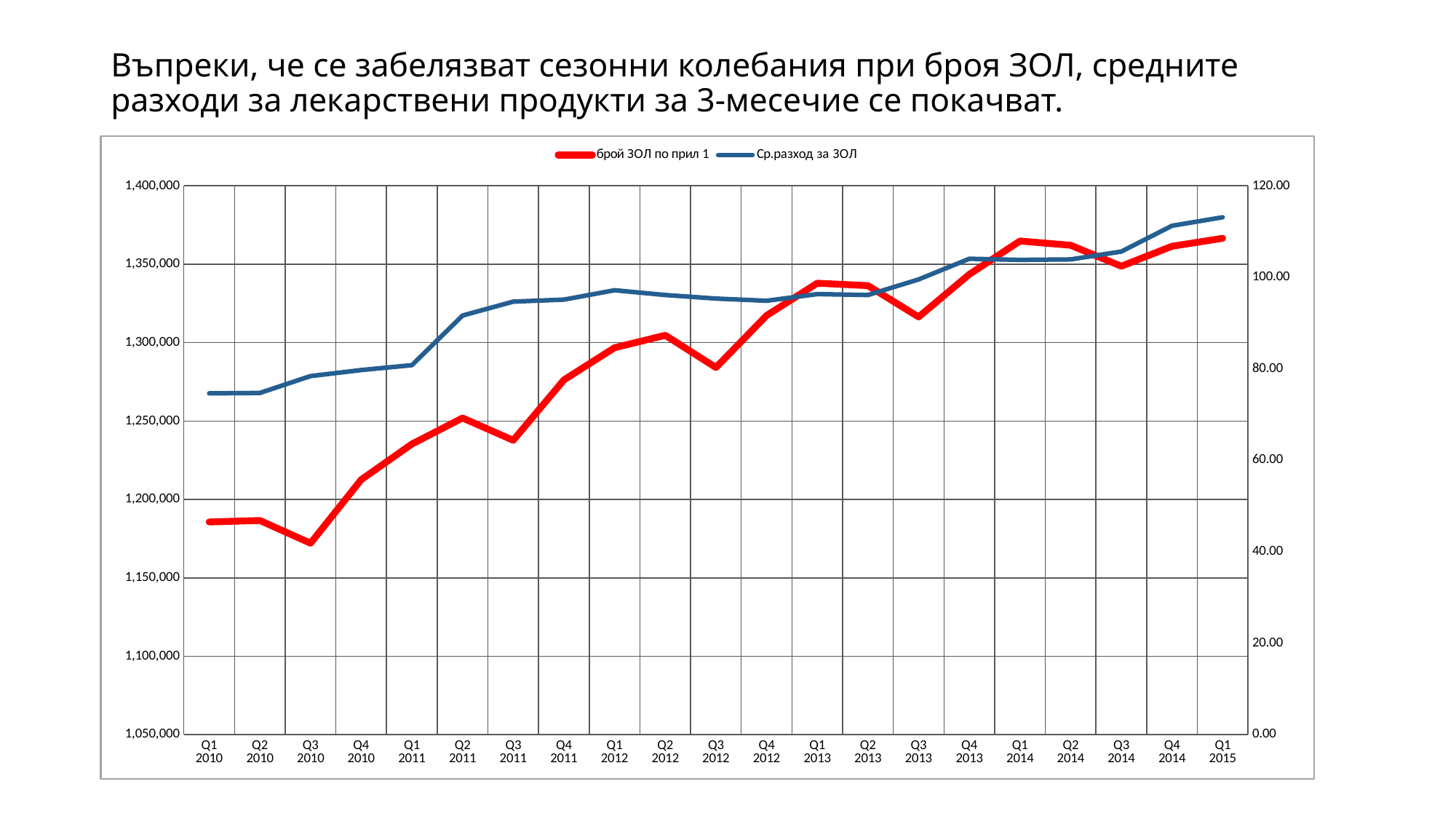
What colour is the line for 'Ср.разход за ЗОЛ'? blue In which quarter is the value of 'брой ЗОЛ по прил 1' lowest? Q3 2010 Which is larger for 'брой ЗОЛ по прил 1': the value for Q2 2011 or the value for Q3 2011? Q2 2011 Does the 'Ср.разход за ЗОЛ' series generally rise or fall from Q1 2010 to Q1 2015? rise What kind of chart is shown on the slide? line chart How many quarters are plotted along the x axis? 21 Is the value of 'Ср.разход за ЗОЛ' for Q1 2015 greater or less than 100.00? greater In which quarter is the value of 'Ср.разход за ЗОЛ' highest? Q1 2015 How many series does the legend list? 2 Is the value of 'Ср.разход за ЗОЛ' for Q1 2010 greater or less than 80.00? less Is the value of 'брой ЗОЛ по прил 1' for Q3 2010 greater or less than 1,200,000? less